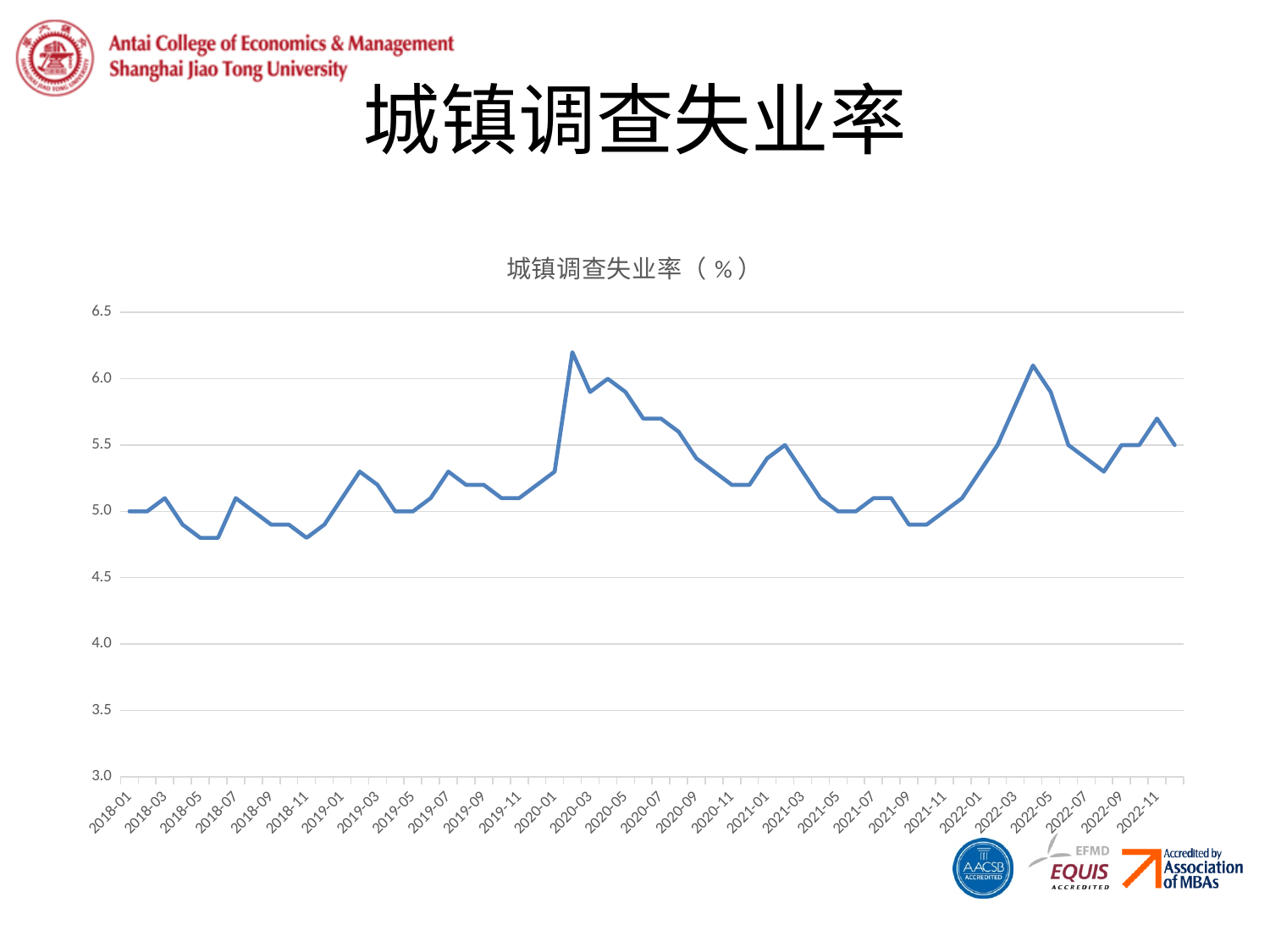
Is the value for 2018-11 greater or less than 5.0? less Does the value rise or fall from 2021-11 to 2022-03? rise Is the value for 2022-05 greater or less than 5.5? greater What is the value for 2018-01? 5.0 Is the value for 2020-03 greater or less than 5.5? greater What is the value for 2021-05? 5.0 Does the value rise or fall from 2020-03 to 2020-11? fall How many lines (data series) are plotted on the chart? 1 What is the title of the chart? 城镇调查失业率（%） What kind of chart is shown on the slide? line chart Which is larger, the value for 2020-03 or the value for 2021-05? 2020-03